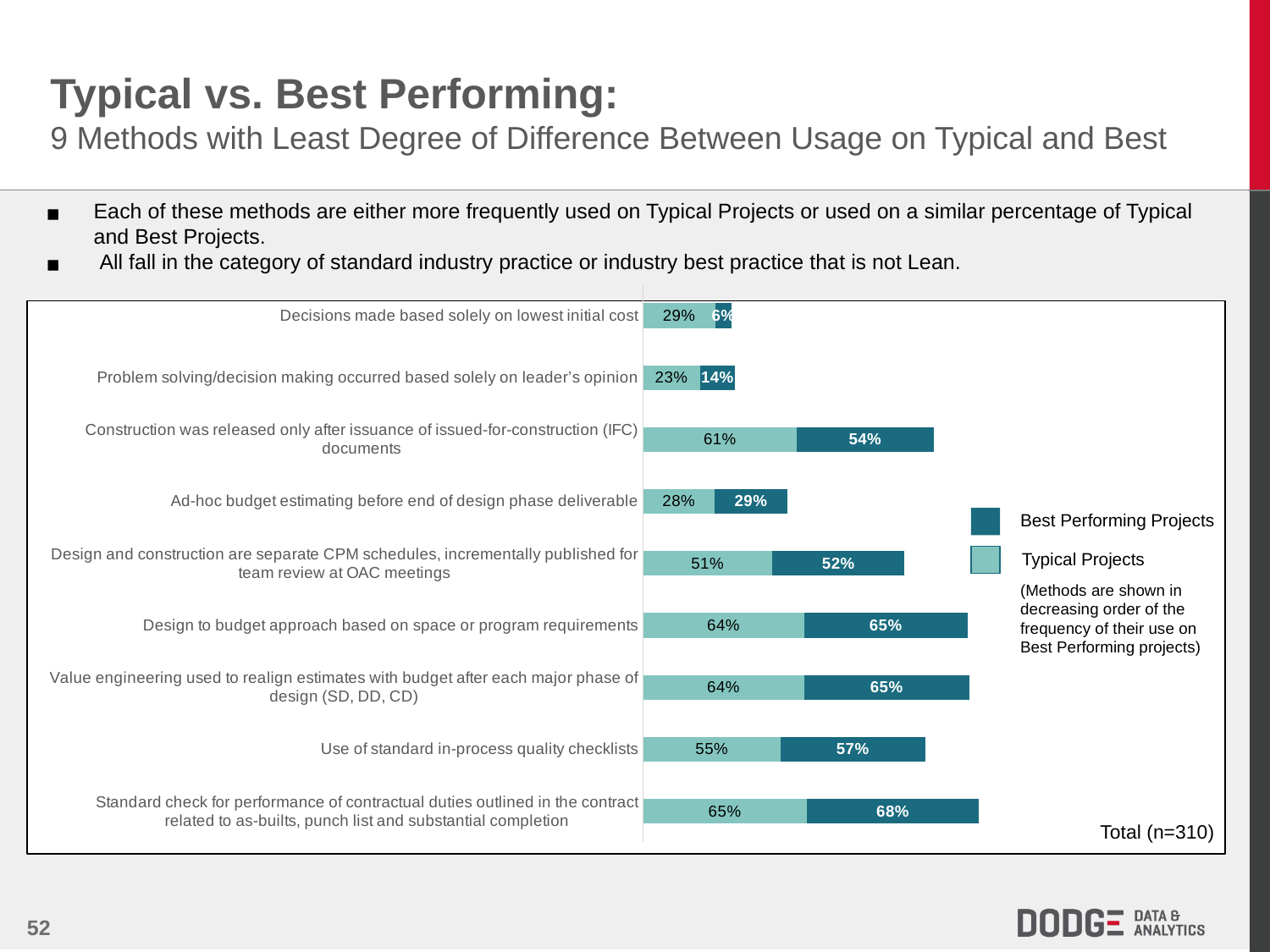
What is the sample size noted in the bottom right of the chart? Total (n=310) What is the Best Performing Projects value for 'Problem solving/decision making occurred based solely on leader's opinion'? 14% How many methods are shown in the chart? 9 What is the difference between the Typical Projects and Best Performing Projects percentages for 'Construction was released only after issuance of issued-for-construction (IFC) documents'? 7 percentage points What percentage of Typical Projects used 'Construction was released only after issuance of issued-for-construction (IFC) documents'? 61% How many series does the legend list? 2 What percentage of Best Performing Projects used 'Use of standard in-process quality checklists'? 57% Which method has the lowest Typical Projects percentage? Problem solving/decision making occurred based solely on leader's opinion What is the combined total of the Typical Projects and Best Performing Projects segments for 'Design to budget approach based on space or program requirements'? 129% For 'Decisions made based solely on lowest initial cost', which is larger: the Typical Projects value or the Best Performing Projects value? Typical Projects What type of chart is shown on the slide? Stacked bar chart Which method has the highest Best Performing Projects percentage? Standard check for performance of contractual duties outlined in the contract related to as-builts, punch list and substantial completion